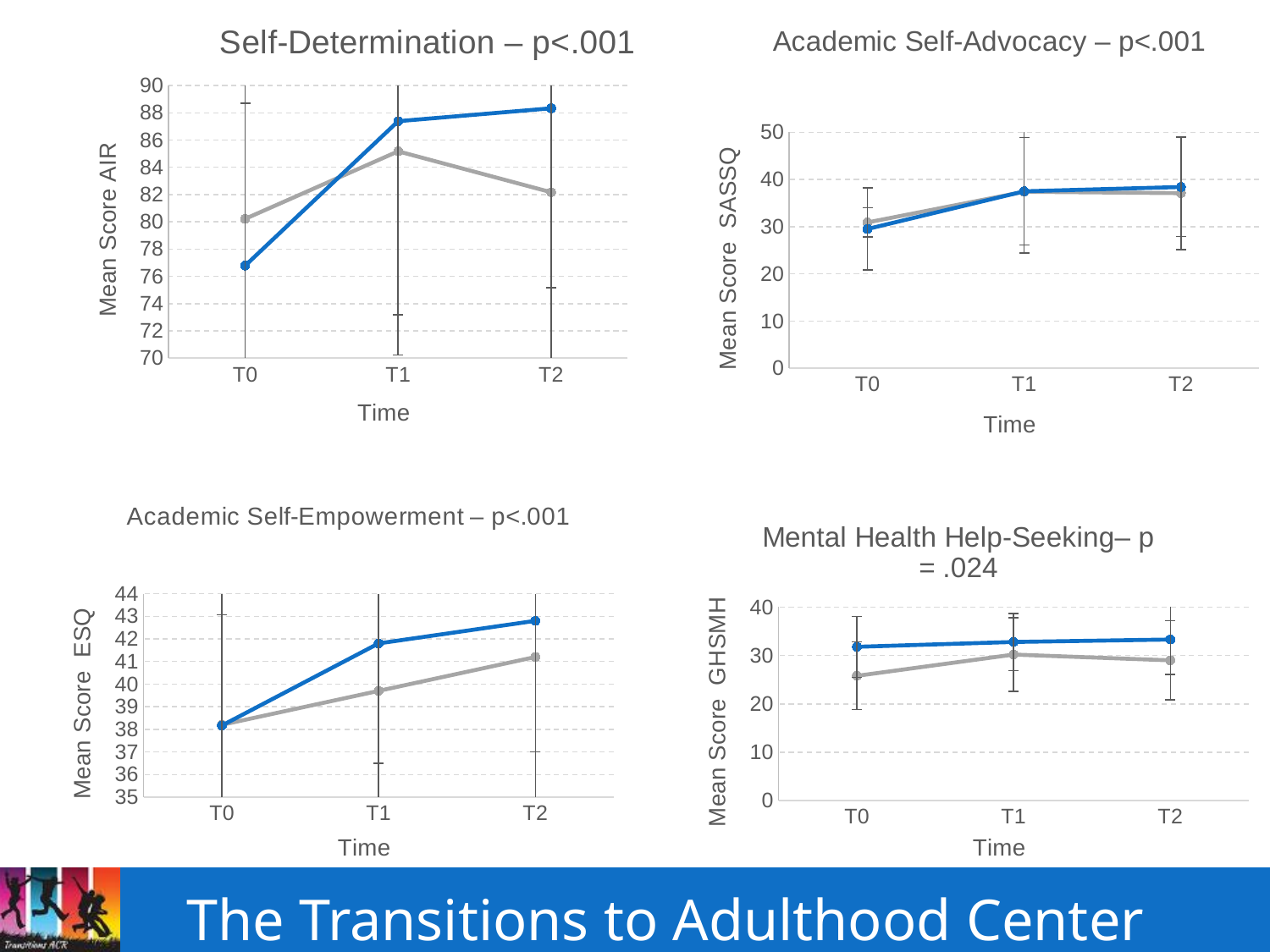
In the Self-Determination chart, how many time points are plotted on the x axis? 3 In the Self-Determination chart, at T2, which line has the higher value, the blue line or the gray line? the blue line In the Self-Determination chart, does the blue line rise or fall from T0 to T2? rise In the Academic Self-Advocacy chart, does the blue line rise or fall from T0 to T1? rise In the Academic Self-Advocacy chart, is the value of the blue line at T2 greater or less than 40? less In the Self-Determination chart, is the value of the blue line at T0 greater or less than 78? less In the Self-Determination chart, what kind of chart is shown? line chart In the Mental Health Help-Seeking chart, is the value of the gray line at T0 greater or less than 30? less In the Academic Self-Empowerment chart, at T1, which line has the higher value, the blue line or the gray line? the blue line In the Self-Determination chart, at which time point does the gray line reach its highest value? T1